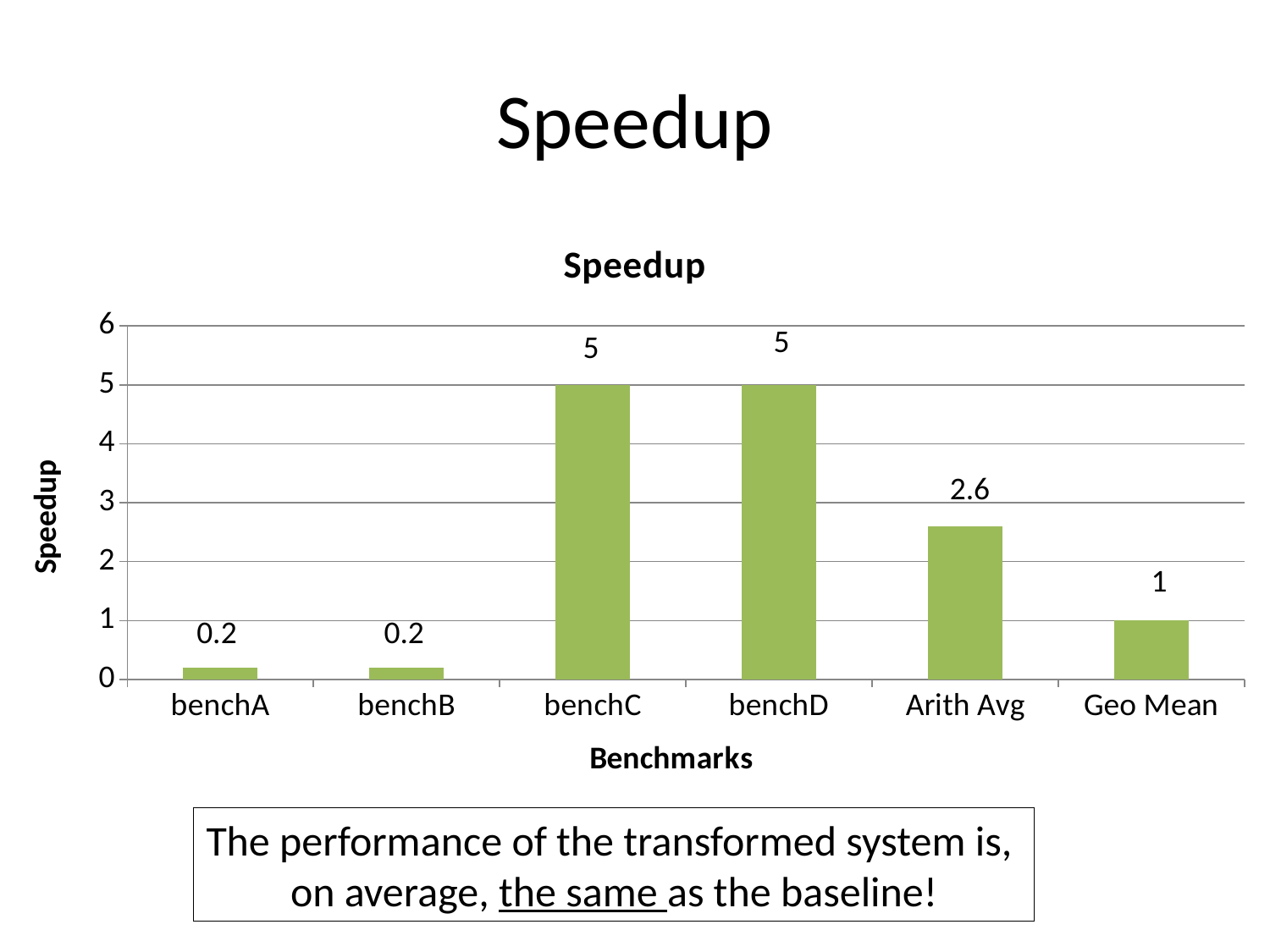
How many categories are shown on the x axis of the chart? 6 Which category has the lowest speedup value, benchA or benchC? benchA What is the speedup value for benchC? 5 What is the speedup value for Arith Avg? 2.6 Is the value for Arith Avg greater or less than 2? greater What is the difference between the speedup for benchD and the speedup for Arith Avg? 2.4 What is the title of the chart? Speedup What is the difference between the Arith Avg speedup and the Geo Mean speedup? 1.6 What kind of chart is shown on the slide? bar chart What is the speedup value for benchA? 0.2 What is the speedup value for Geo Mean? 1 What is the label of the x axis of the chart? Benchmarks